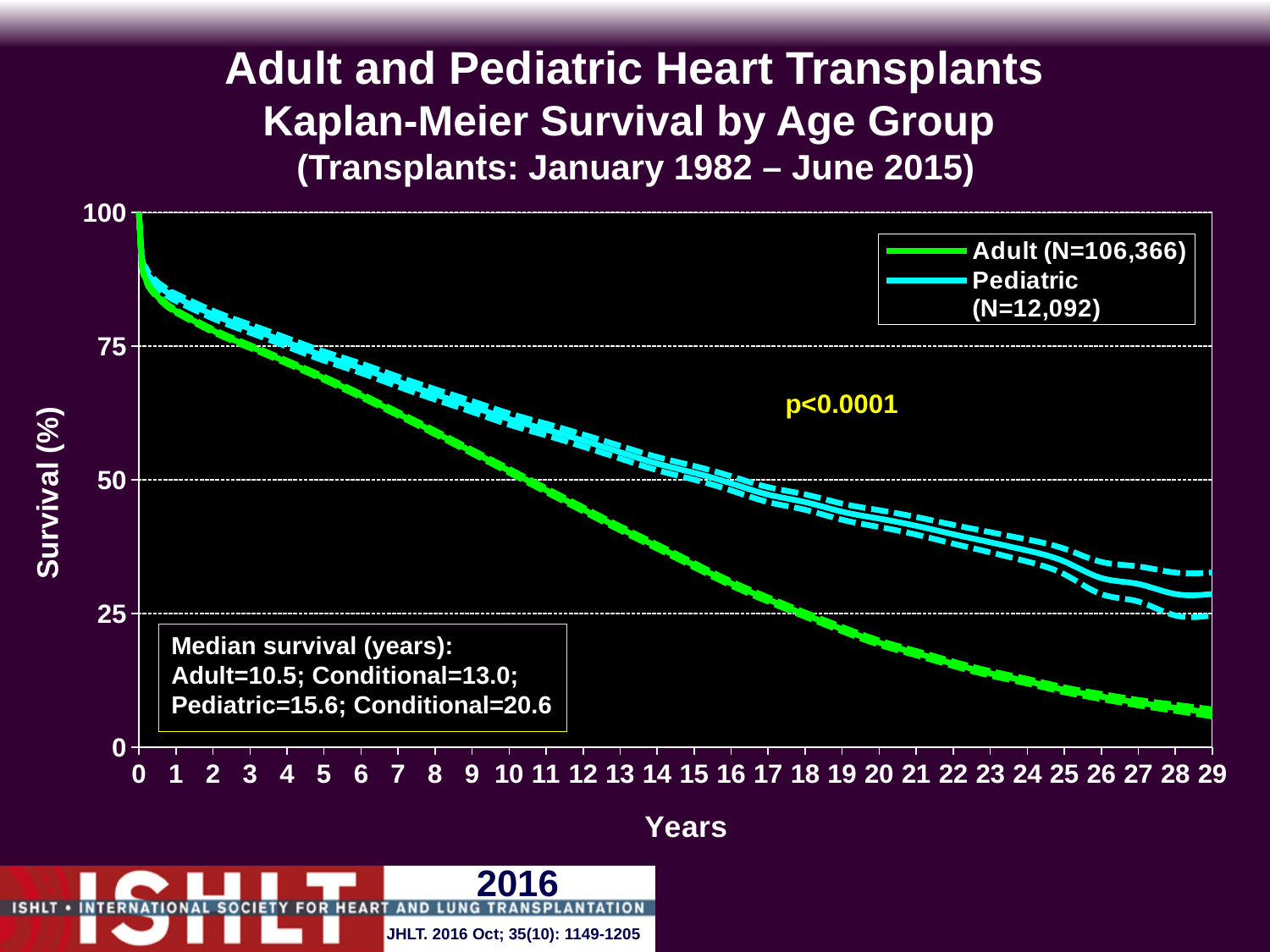
How many series does the legend list? 2 What p-value is shown on the chart? p<0.0001 Is the Adult survival value at 5 years greater or less than 50? greater Is the Pediatric survival value at 20 years greater or less than 50? less Is the Adult survival value at 29 years greater or less than 25? less What is the N for the Adult group shown in the legend? 106,366 What is the conditional median survival in years for the Pediatric group, as stated in the text box? 20.6 What kind of chart is shown on the slide? line chart At 20 years, which group has the higher survival, Adult or Pediatric? Pediatric Do the survival curves rise or fall as years increase? fall What is the median survival in years for the Adult group, as stated in the text box? 10.5